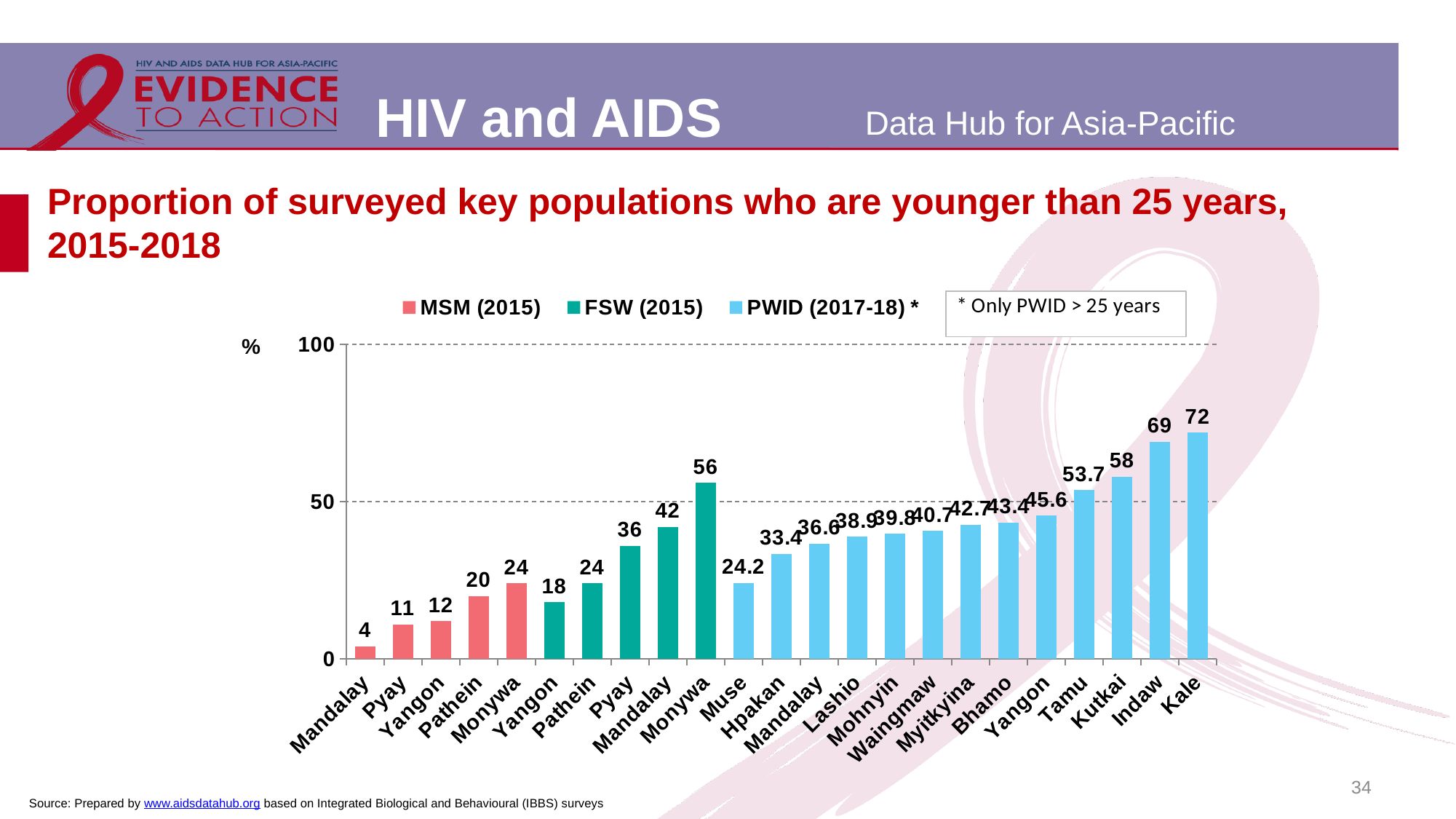
What is the value for Monywa in the FSW (2015) series? 56 Which location has the lowest bar on the chart? Mandalay (MSM) Is the value for Tamu in the PWID (2017-18) series greater or less than 50? greater What is the difference between the values for Kale and Indaw in the PWID (2017-18) series? 3 What kind of chart is shown on the slide? bar chart Which is larger: the value for Mandalay in the FSW (2015) series or the value for Monywa in the MSM (2015) series? Mandalay in FSW (2015) Which location has the highest bar on the chart? Kale How many series does the legend list? 3 What is the difference between the values for Monywa and Yangon in the FSW (2015) series? 38 What is the value for Kale in the PWID (2017-18) series? 72 What is the value for Mandalay in the MSM (2015) series? 4 How many bars are plotted on the chart? 23